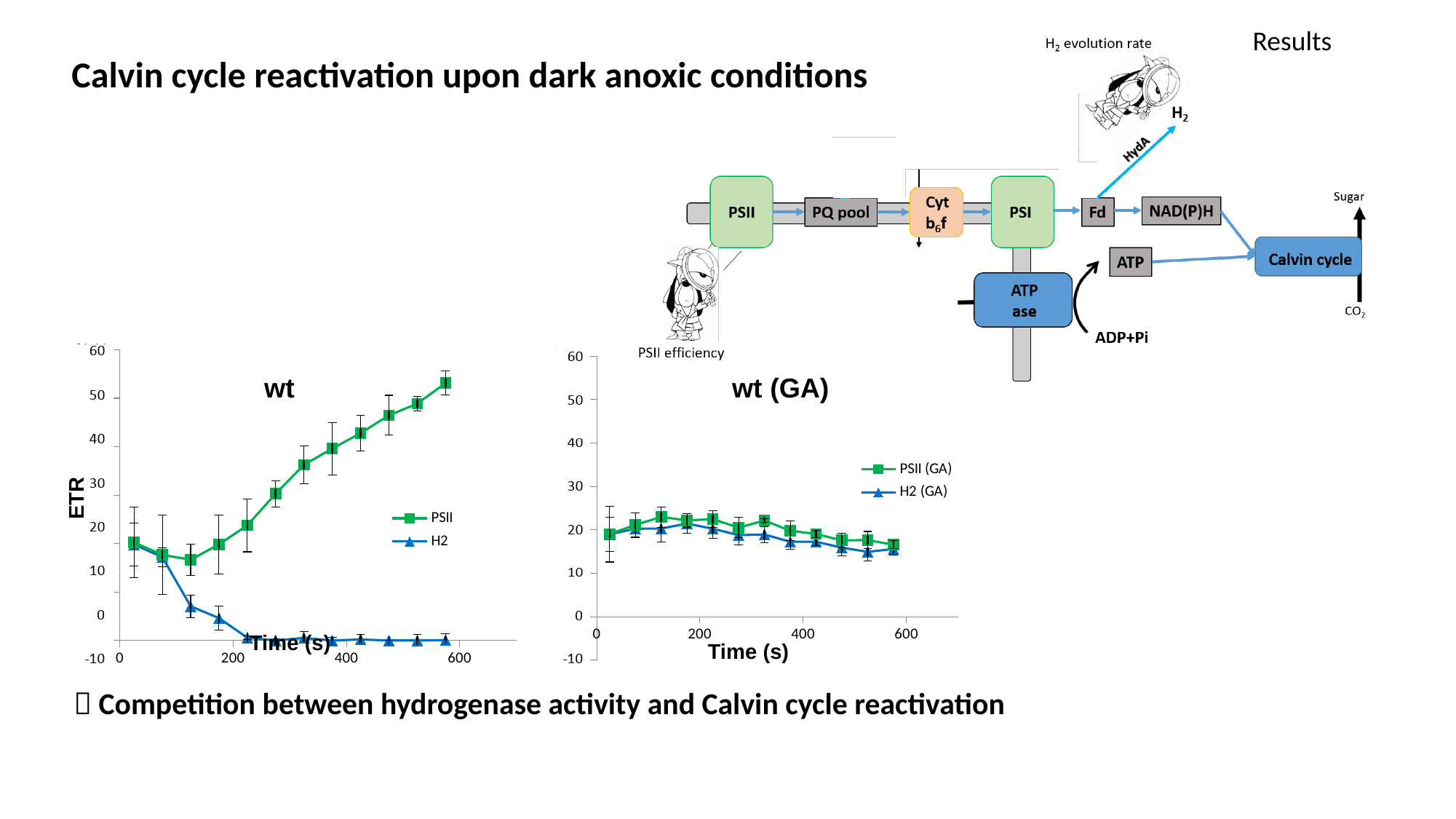
What is the y-axis label of the 'wt' chart? ETR In the 'wt' chart, is the final PSII value (near 600 s) greater or less than 50? greater In the 'wt' chart, which series has the larger value near 600 s, PSII or H2? PSII In the 'wt' chart, does the H2 series rise or fall between 0 s and 200 s? fall How many series does the legend of the 'wt (GA)' chart list? 2 In the 'wt (GA)' chart, is the PSII (GA) value near 100 s greater or less than 30? less What kind of chart is the 'wt' chart on the left? line chart What are the legend entries of the 'wt' chart? PSII and H2 In the 'wt' chart, does the PSII series rise or fall between 200 s and 600 s? rise In the 'wt (GA)' chart, is the H2 (GA) value near 600 s greater or less than 10? greater